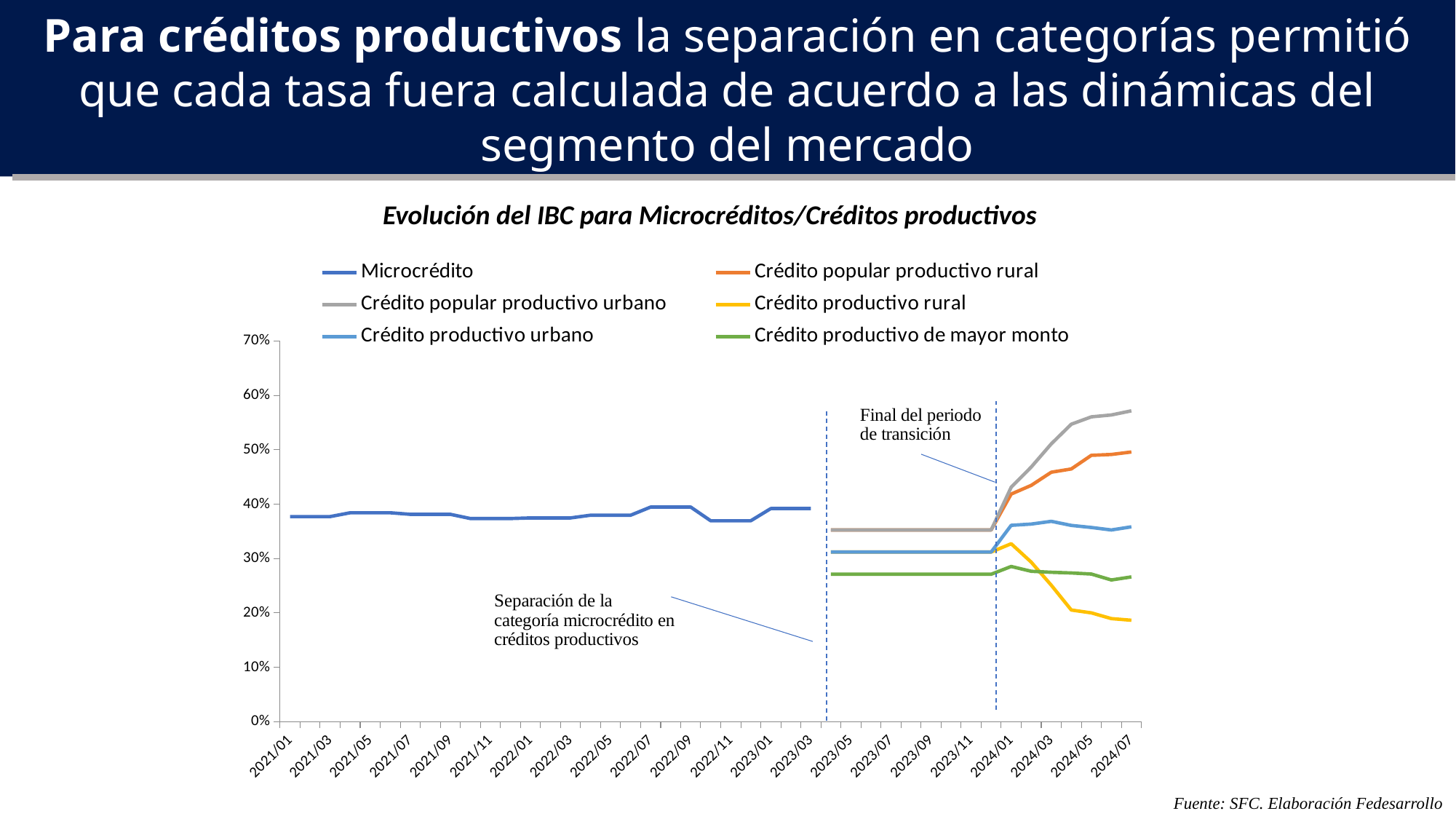
Which series has the lowest value at 2024/07? Crédito productivo rural How many series does the legend of the chart list? 6 Does the value for Crédito productivo rural rise or fall between 2024/01 and 2024/07? fall How many date labels are shown on the x axis of the chart? 22 What source is cited for the chart? SFC. Elaboración Fedesarrollo Is the value for Crédito popular productivo urbano at 2024/07 greater or less than 50%? greater What kind of chart is shown on the slide? Line chart What is the title of the chart? Evolución del IBC para Microcréditos/Créditos productivos Is the value for Microcrédito at 2021/01 greater or less than 40%? less Which series has the highest value at 2024/07? Crédito popular productivo urbano At 2024/07, which is larger: Crédito popular productivo rural or Crédito productivo urbano? Crédito popular productivo rural Is the value for Crédito productivo de mayor monto at 2024/07 greater or less than 30%? less